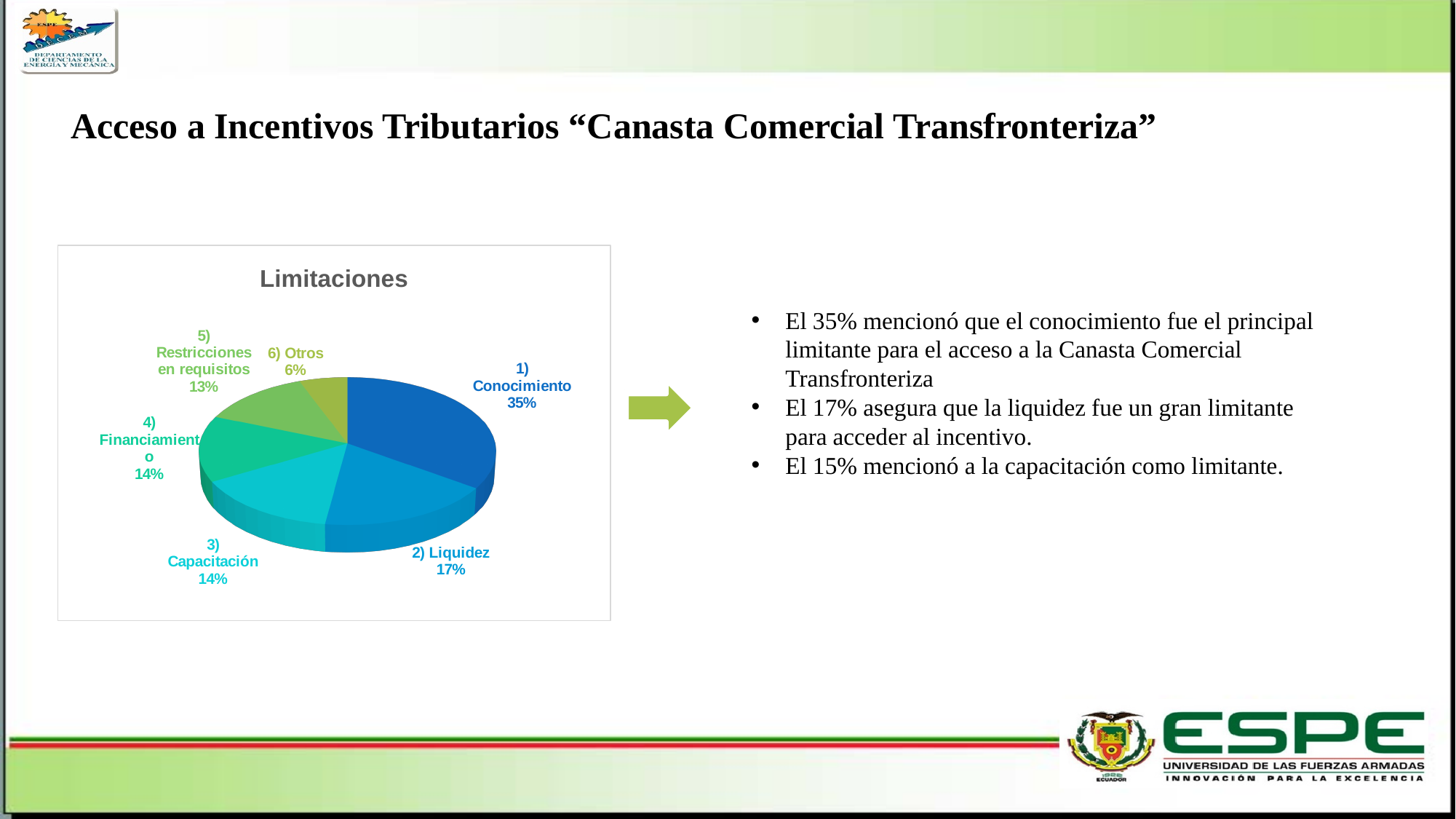
What is the title of the chart on the slide? Limitaciones Which category has the smallest share in the Limitaciones pie chart? 6) Otros What percentage is shown for "3) Capacitación" in the Limitaciones pie chart? 14% What percentage is shown for "6) Otros" in the Limitaciones pie chart? 6% In the Limitaciones pie chart, which is larger: "2) Liquidez" or "5) Restricciones en requisitos"? 2) Liquidez How many slices does the Limitaciones pie chart have? 6 What percentage does the "1) Conocimiento" slice represent in the Limitaciones pie chart? 35% What percentage is shown for "5) Restricciones en requisitos" in the Limitaciones pie chart? 13% What type of chart is shown under the title "Limitaciones"? Pie chart What percentage does the "2) Liquidez" slice represent in the Limitaciones pie chart? 17% In the Limitaciones pie chart, what is the difference in percentage points between "1) Conocimiento" and "2) Liquidez"? 18 Which category has the largest share in the Limitaciones pie chart? 1) Conocimiento